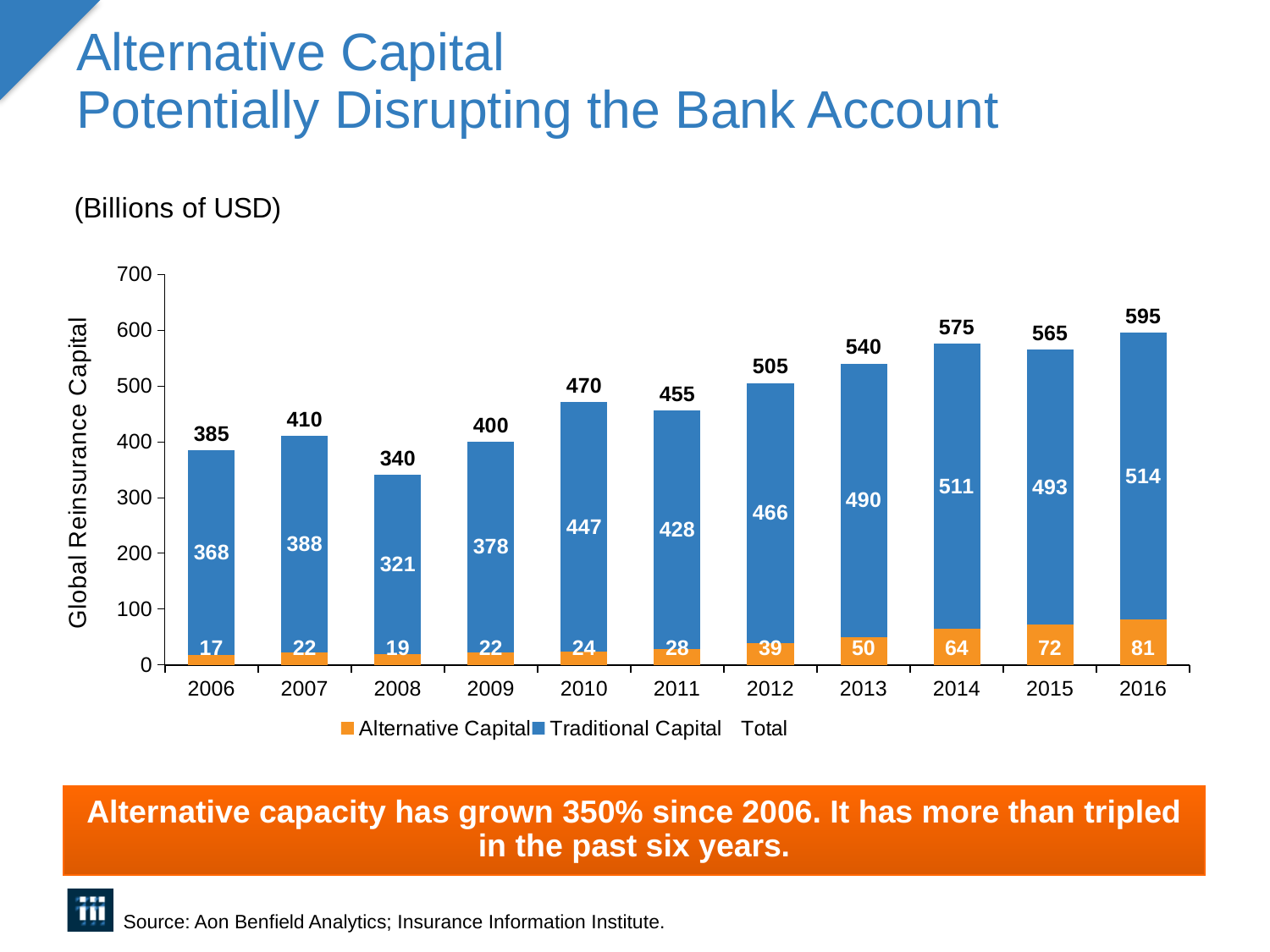
Which year has the lowest Total value? 2008 Which year has the highest Total value? 2016 Do the Alternative Capital values generally rise or fall from 2009 to 2016? Rise Which is larger, the Traditional Capital value for 2014 or for 2015? 2014 What is the Total value shown for 2013? 540 How many years are shown on the x axis? 11 How many series does the legend list? 3 What is the difference between the Alternative Capital values for 2016 and 2006? 64 What kind of chart is shown on the slide? Stacked bar chart What is the Traditional Capital value for 2010? 447 What is the Alternative Capital value for 2016? 81 What is the label on the y axis? Global Reinsurance Capital